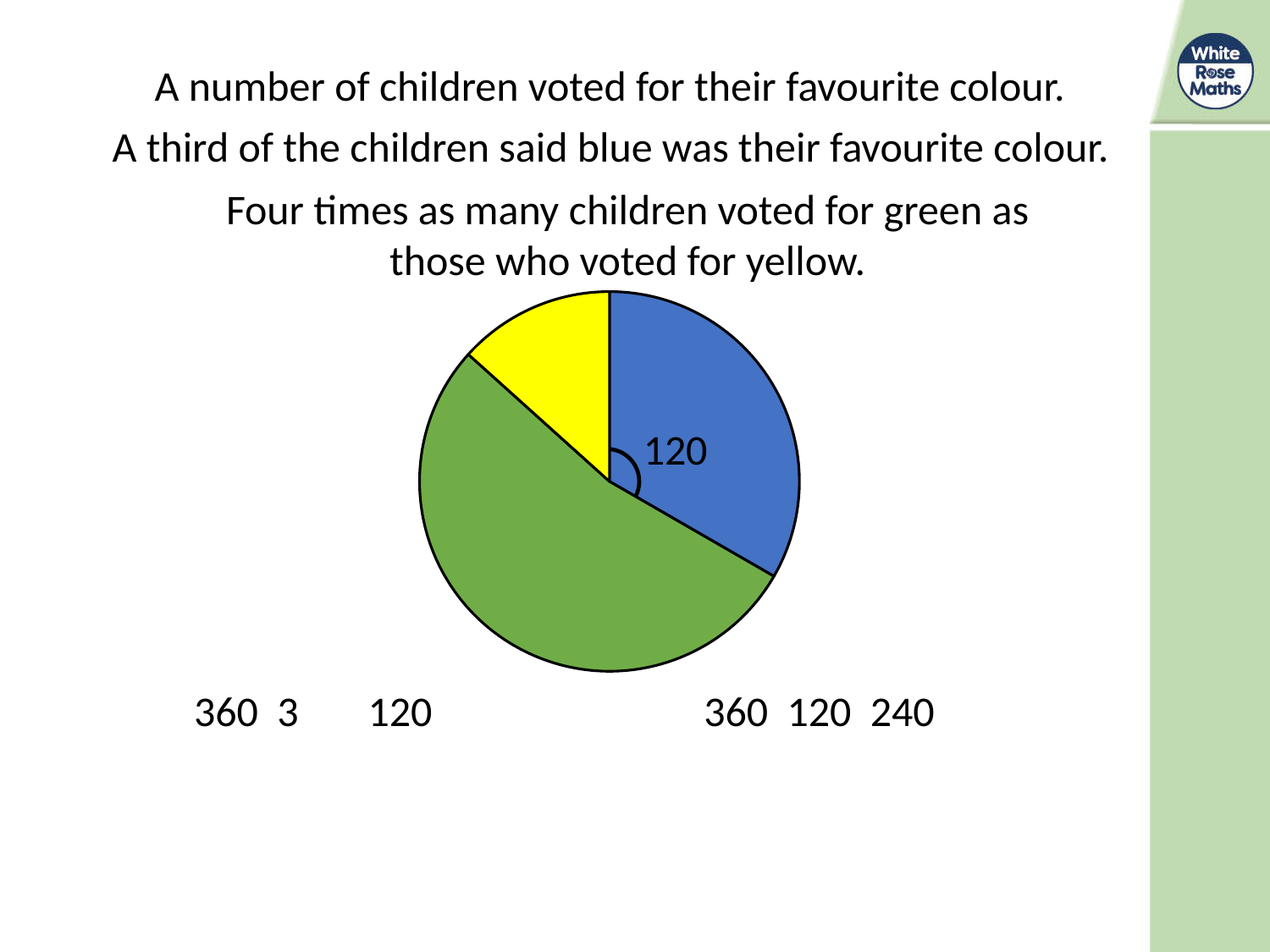
What colours are the three slices of the pie chart? blue, green and yellow According to the slide, how many times as many children voted for green as for yellow? four times Which colour slice is the smallest in the pie chart? yellow Which slice is larger, the blue slice or the yellow slice? blue Which colour slice is the largest in the pie chart? green What angle is labelled on the blue slice of the pie chart? 120 How many slices does the pie chart have? 3 What kind of chart is shown on the slide? pie chart Which slice is larger, the green slice or the blue slice? green What fraction of the children said blue was their favourite colour, according to the slide? a third